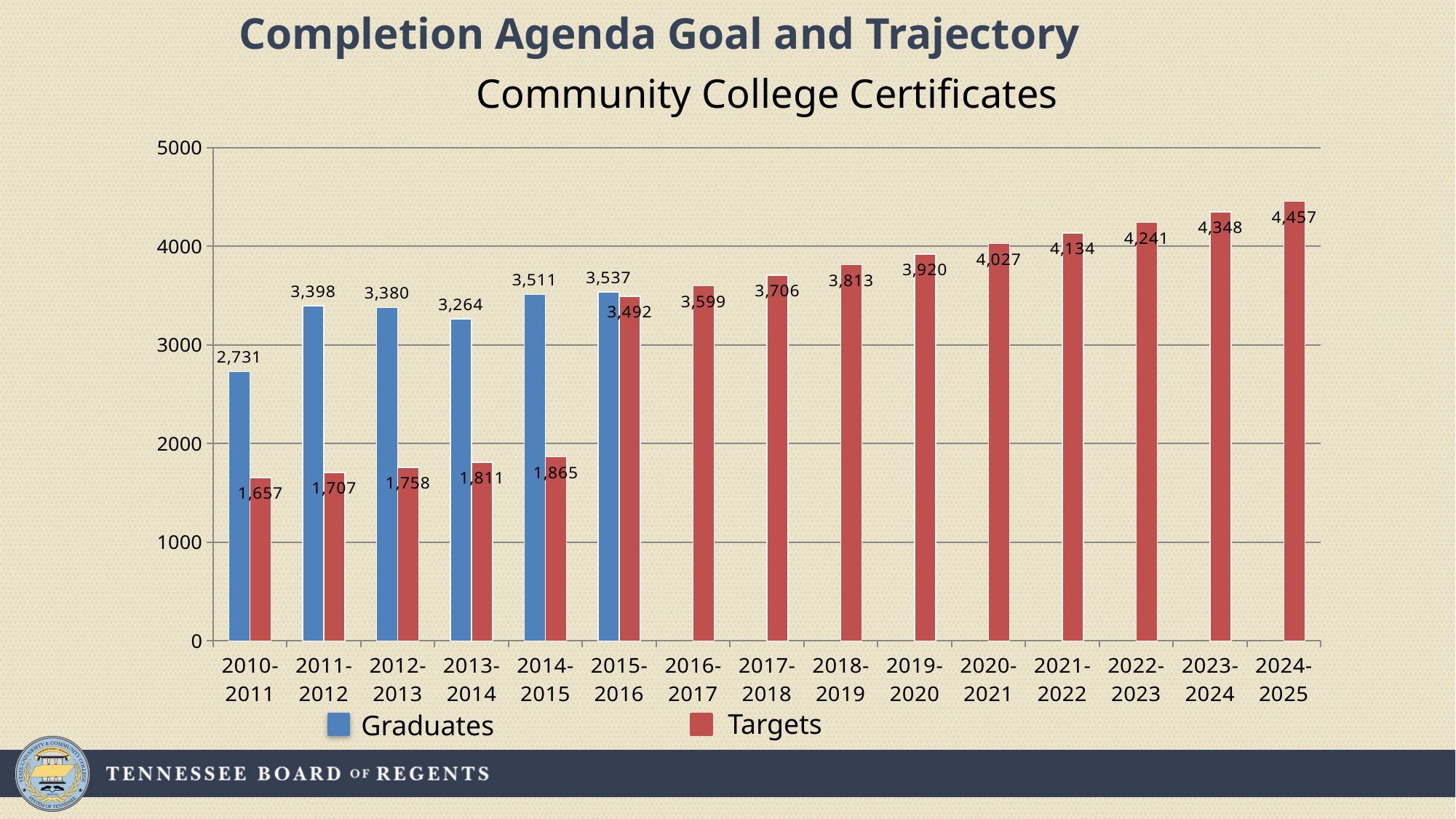
What is the Graduates value for 2010-2011? 2,731 How many year categories are shown on the x axis? 15 Which year has the lowest Targets value? 2010-2011 What kind of chart is shown on the slide? bar chart What is the Targets value for 2015-2016? 3,492 Which is larger, the Graduates value for 2011-2012 or for 2012-2013? 2011-2012 Do the Targets values rise or fall from 2015-2016 to 2024-2025? rise What is the Targets value for 2024-2025? 4,457 How many series does the legend list? 2 What is the difference between the Targets values for 2024-2025 and 2023-2024? 109 Which year has the highest Graduates value? 2015-2016 What is the difference between the Graduates value and the Targets value for 2015-2016? 45